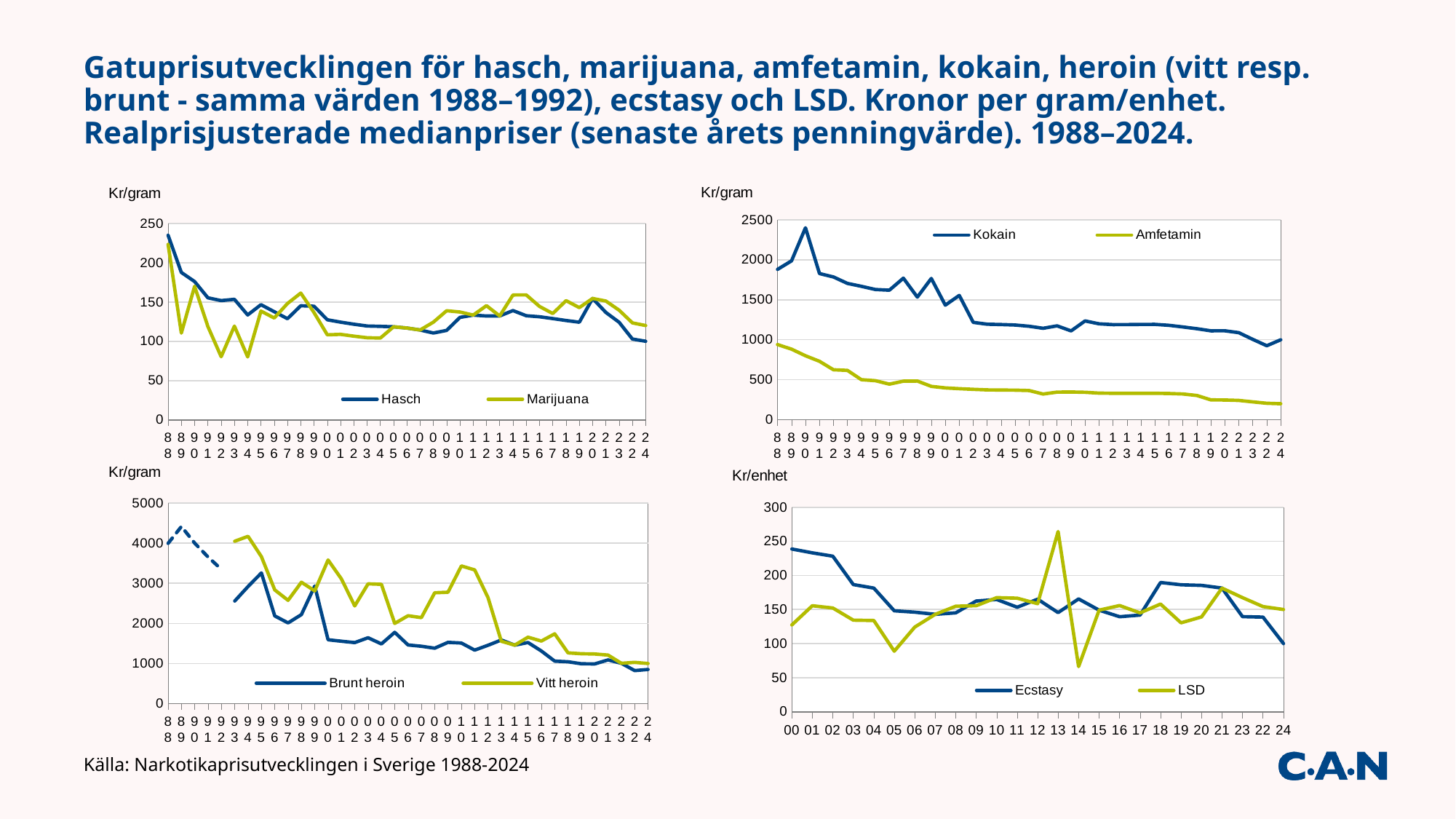
In the top-right chart, does the Amfetamin line generally rise or fall from 1988 to 2024? fall What kind of chart is the top-left chart showing Hasch and Marijuana? line chart In the bottom-right chart, is the value for LSD in 2013 greater or less than 250? greater How many series does the legend of the top-right chart (Kokain and Amfetamin) list? 2 What is the y-axis unit label of the bottom-right chart (Ecstasy and LSD)? Kr/enhet In the bottom-right chart, which series has the higher value in 2014, Ecstasy or LSD? Ecstasy In the bottom-left chart, is the value for Brunt heroin in 2024 greater or less than 1000? less In the top-left chart, is the value for Hasch in 1988 greater or less than 200? greater In the top-right chart, which series has the higher value in 2024, Kokain or Amfetamin? Kokain